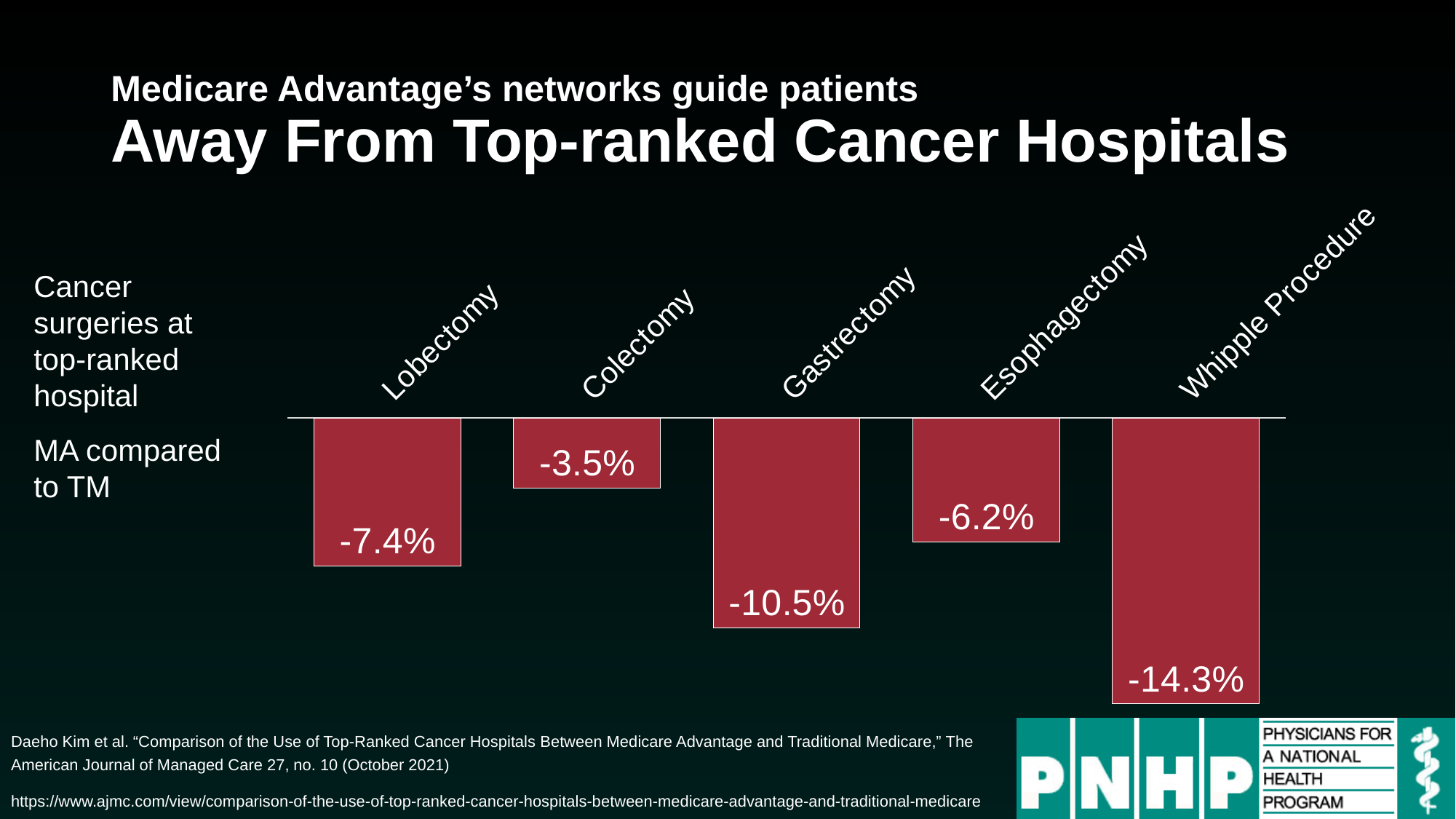
What is the difference between the values for Whipple Procedure and Colectomy? 10.8 percentage points Which has a larger decrease, Gastrectomy or Esophagectomy? Gastrectomy How many surgery categories are shown in the chart? 5 Which surgery has the highest (least negative) value? Colectomy What is the value for Esophagectomy? -6.2% What is the value for Lobectomy? -7.4% What is the value for Colectomy? -3.5% What is the value for Gastrectomy? -10.5% Which surgery has the lowest (most negative) value? Whipple Procedure What kind of chart is shown on the slide? Bar chart What is the value for Whipple Procedure? -14.3% What colour are the bars in the chart? Red